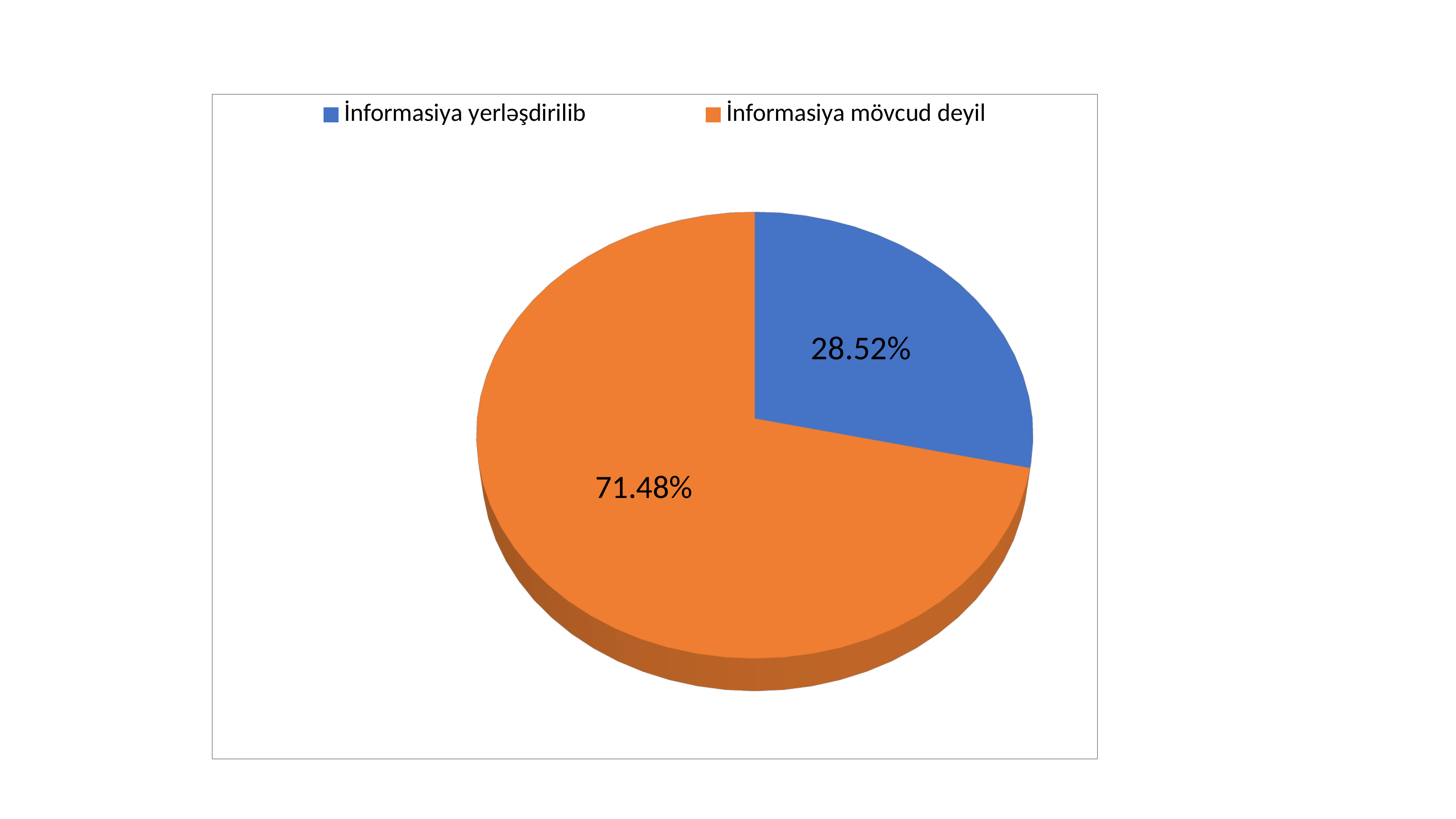
Which is larger, İnformasiya yerləşdirilib or İnformasiya mövcud deyil? İnformasiya mövcud deyil What colour is the İnformasiya yerləşdirilib slice? blue What is the value for İnformasiya yerləşdirilib? 28.52% Which category has the smallest slice? İnformasiya yerləşdirilib What is the difference between the İnformasiya mövcud deyil and İnformasiya yerləşdirilib slices? 42.96% Which category has the largest slice? İnformasiya mövcud deyil How many slices does the pie chart have? 2 What colour is the İnformasiya mövcud deyil slice? orange What kind of chart is shown on the slide? pie chart What share of the pie does İnformasiya mövcud deyil take? 71.48% How many entries does the legend list? 2 What is the value for İnformasiya mövcud deyil? 71.48%